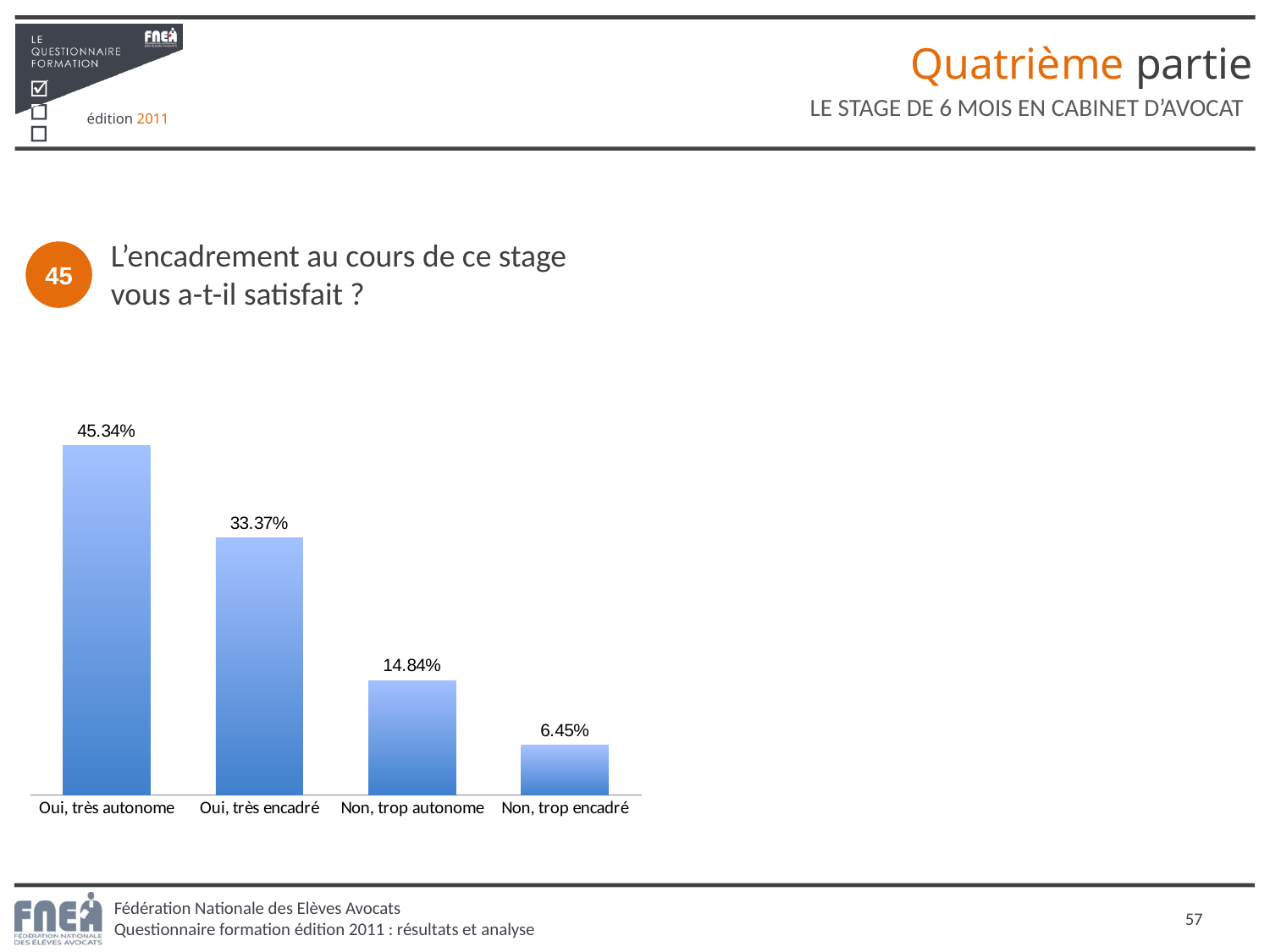
What is the value shown for "Non, trop autonome"? 14.84% What percentage of respondents answered "Oui, très autonome"? 45.34% Do the values rise or fall from left to right across the categories? Fall What is the value shown for "Oui, très encadré"? 33.37% What type of chart is shown on the slide? Bar chart How many response categories are shown in the chart? 4 What is the difference between the values for "Non, trop autonome" and "Non, trop encadré"? 8.39% Which response category has the lowest value? Non, trop encadré Which is larger: the value for "Oui, très encadré" or the value for "Non, trop autonome"? Oui, très encadré Which response category has the highest value? Oui, très autonome What is the value shown for "Non, trop encadré"? 6.45% What is the difference between the values for "Oui, très autonome" and "Oui, très encadré"? 11.97%